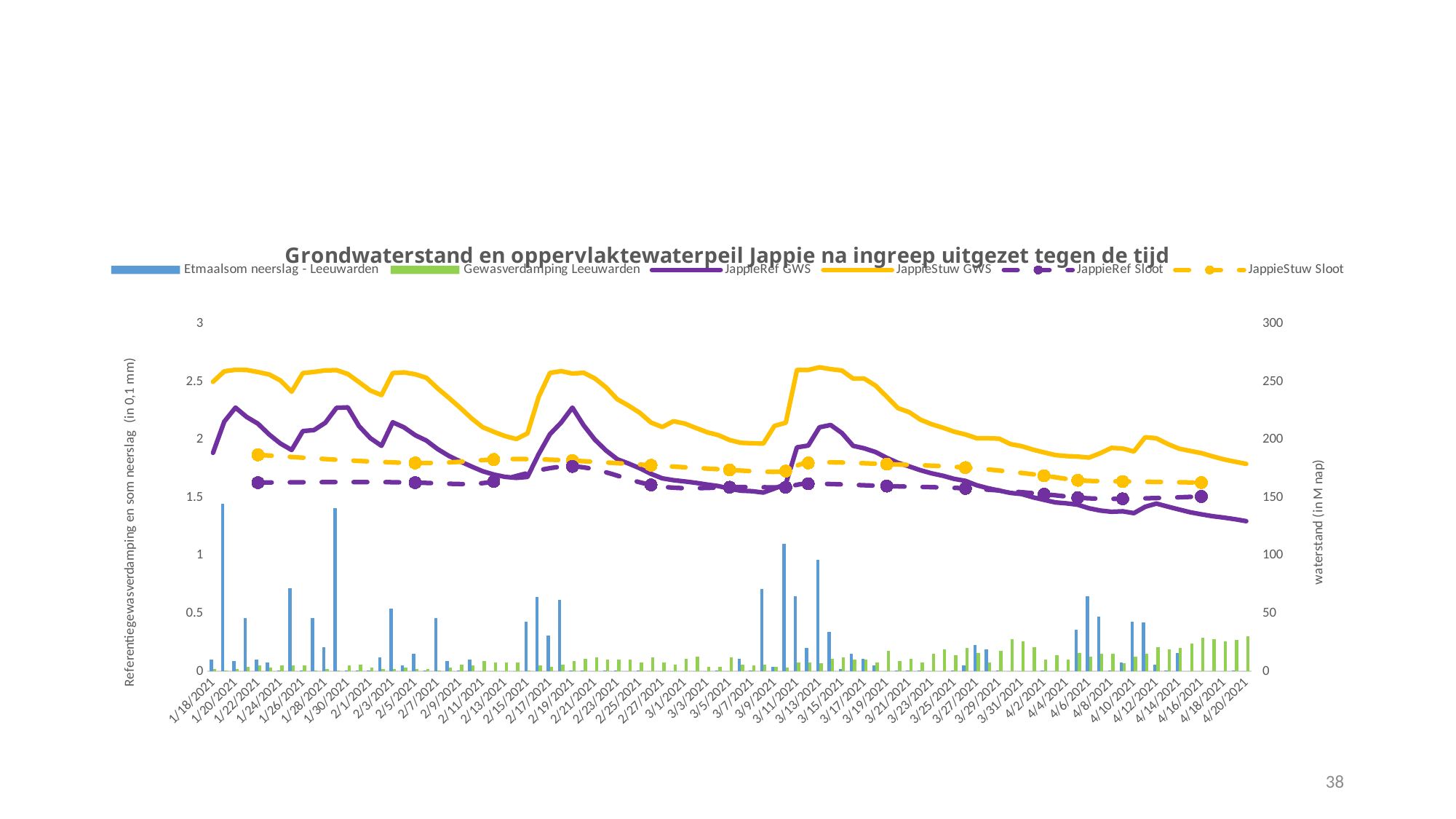
Does the JappieRef Sloot series rise or fall from 1/22/2021 to 4/18/2021? fall At 3/11/2021, which is larger: JappieStuw GWS or JappieRef GWS? JappieStuw GWS Is the tallest Etmaalsom neerslag - Leeuwarden bar greater or less than 1 on the left axis? greater Is the value for JappieRef Sloot at 1/22/2021 greater or less than 200 on the right axis? less What is the title of the right-hand vertical axis? waterstand (in M nap) What kind of chart is shown on the slide? A combination bar and line chart Is the value for JappieRef GWS at 4/20/2021 greater or less than 150 on the right axis? less Does the JappieStuw GWS line overall rise or fall from 1/18/2021 to 4/20/2021? fall What is the title of the chart? Grondwaterstand en oppervlaktewaterpeil Jappie na ingreep uitgezet tegen de tijd At 1/22/2021, which is larger: JappieStuw Sloot or JappieRef Sloot? JappieStuw Sloot How many series does the legend list? 6